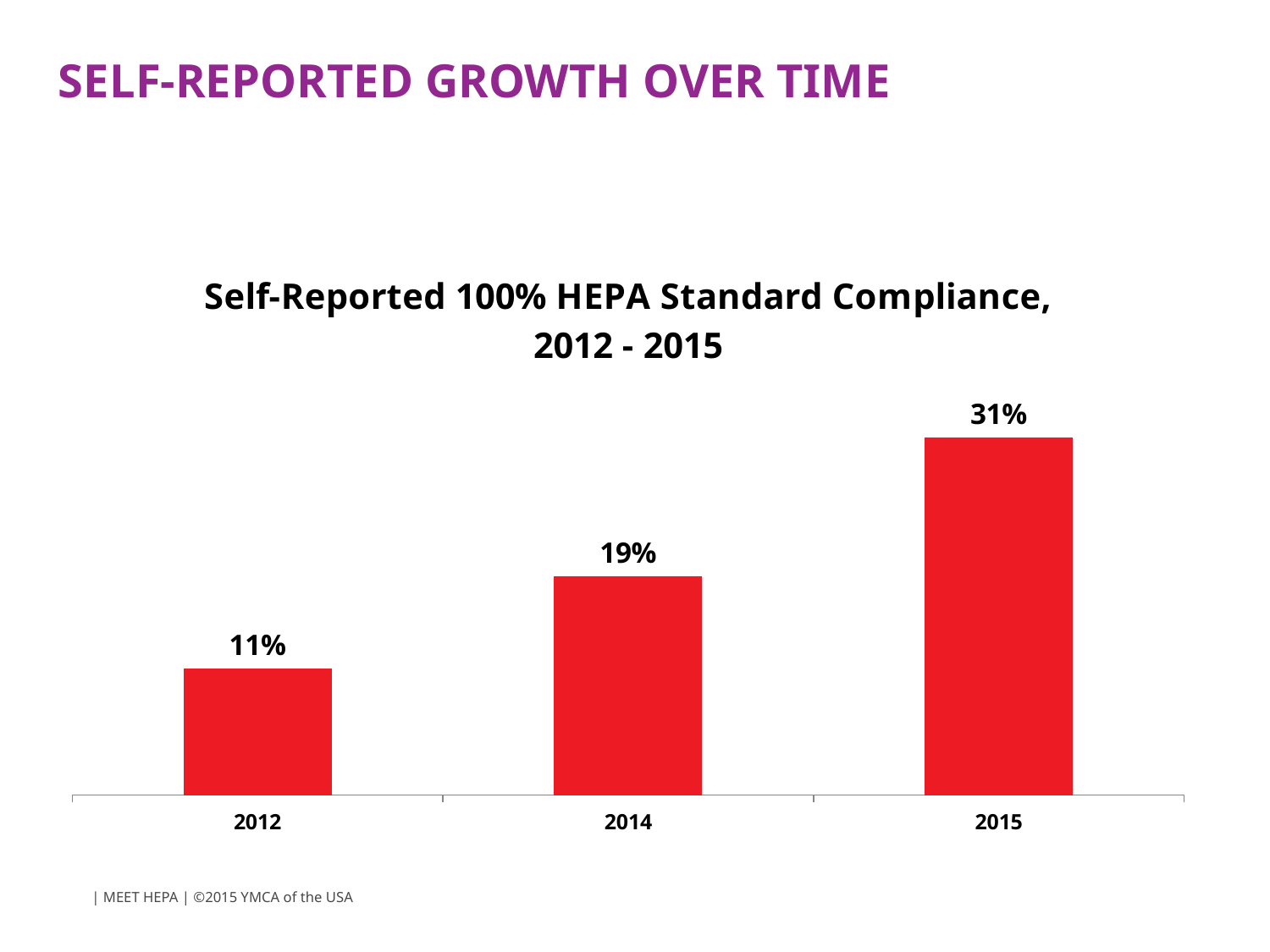
Which year has the highest self-reported compliance value? 2015 Do the compliance values rise or fall from 2012 to 2015? Rise What is the difference between the 2015 and 2012 compliance values? 20% How many years are shown on the chart? 3 Which year has the lowest self-reported compliance value? 2012 What is the difference between the 2014 and 2012 compliance values? 8% What is the self-reported 100% HEPA standard compliance value for 2014? 19% What is the self-reported 100% HEPA standard compliance value for 2012? 11% What is the self-reported 100% HEPA standard compliance value for 2015? 31% What kind of chart is shown on the slide? Bar chart Which year has a larger compliance value, 2014 or 2015? 2015 What is the title of the chart? Self-Reported 100% HEPA Standard Compliance, 2012 - 2015